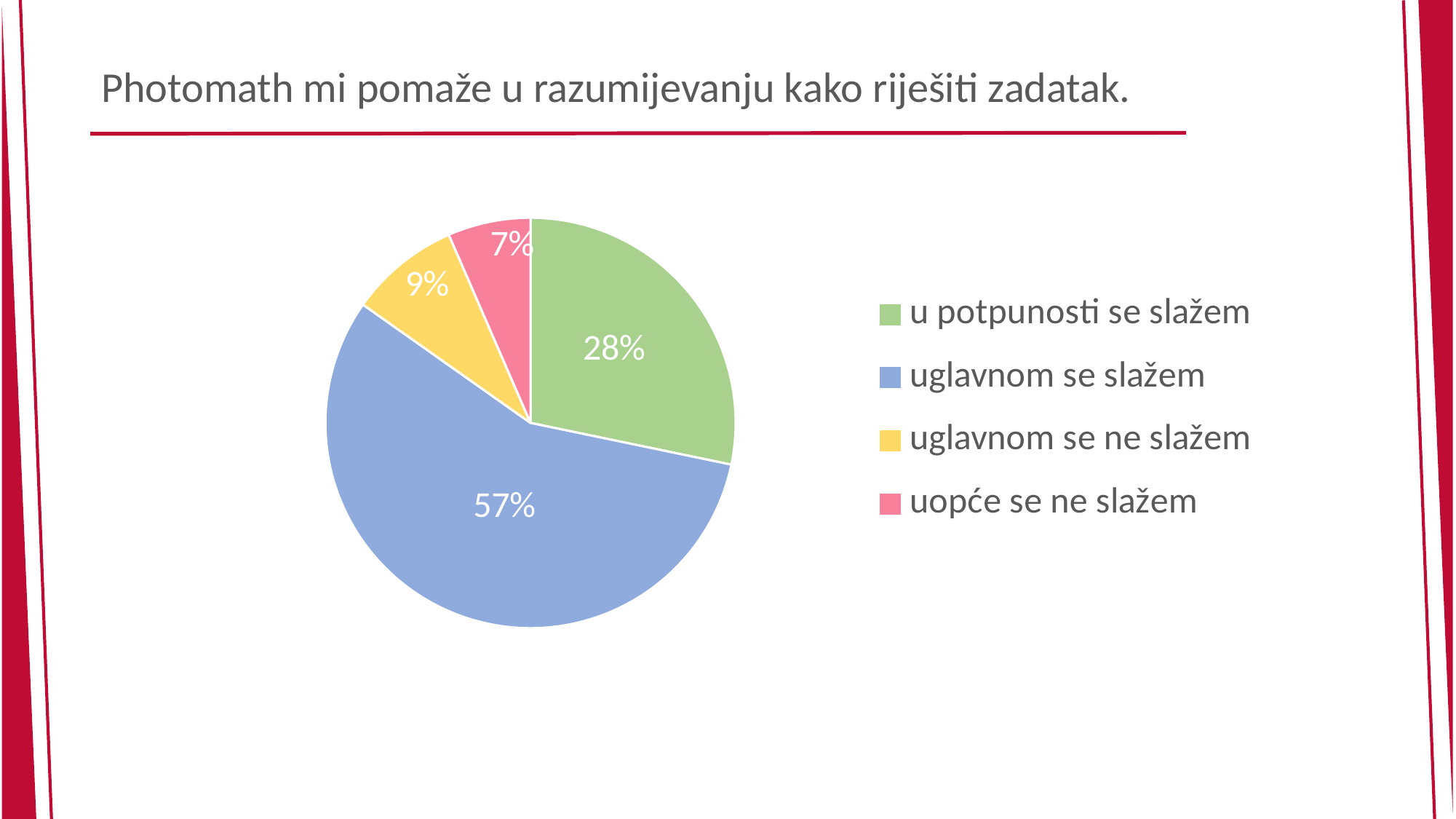
What share of the pie is labelled "u potpunosti se slažem"? 28% Which is larger, the slice for "uglavnom se ne slažem" or the slice for "uopće se ne slažem"? uglavnom se ne slažem What share of the pie is labelled "uopće se ne slažem"? 7% What kind of chart is shown on the slide? pie chart What is the difference in percentage points between "uglavnom se slažem" and "u potpunosti se slažem"? 29 What share of the pie is labelled "uglavnom se ne slažem"? 9% Which category has the largest slice of the pie? uglavnom se slažem What colour is the slice for "u potpunosti se slažem"? green How many slices does the pie chart have? 4 How many entries does the legend list? 4 Which category has the smallest slice of the pie? uopće se ne slažem